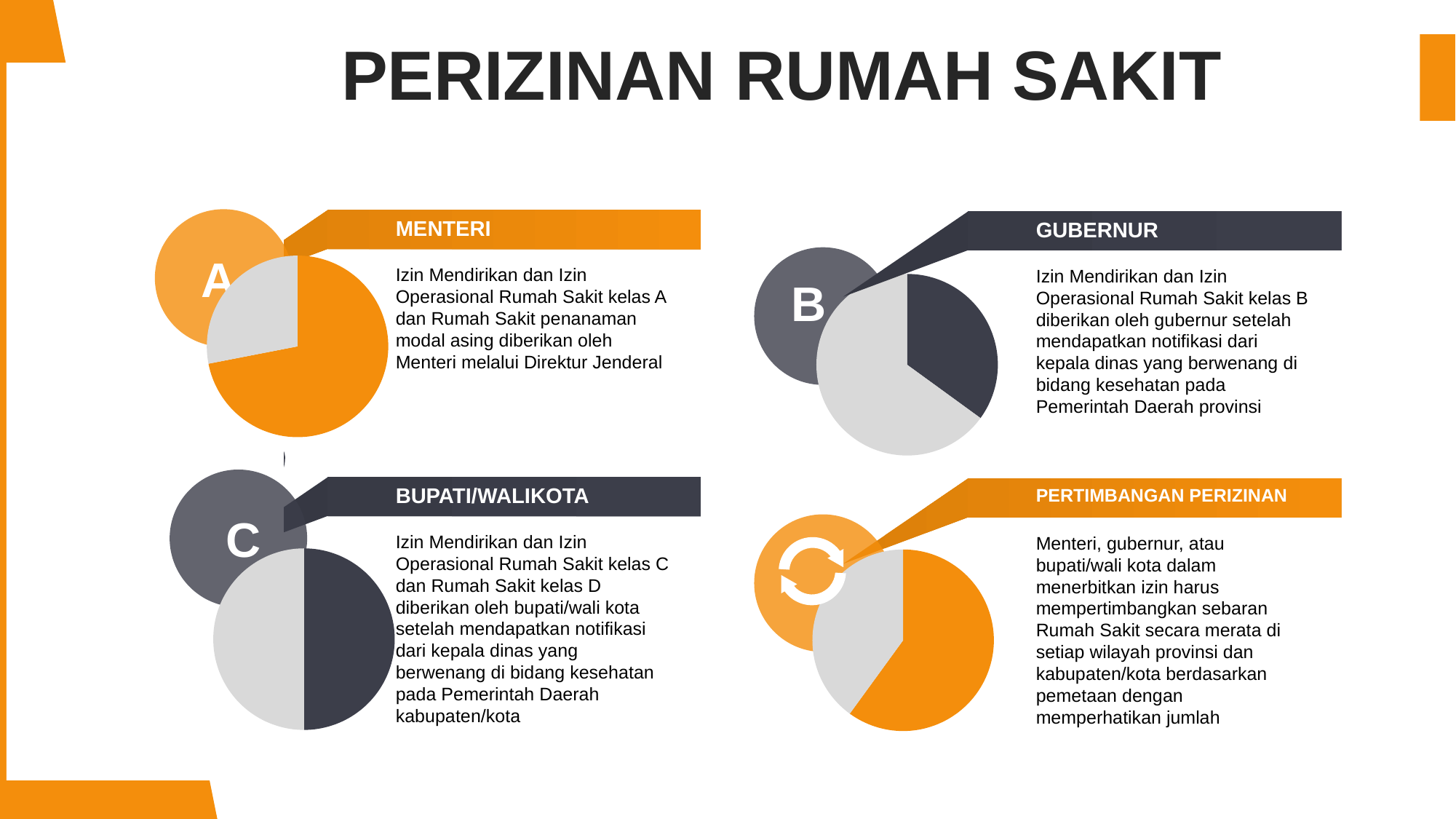
In the pie chart next to the MENTERI heading, which slice is larger, the orange one or the grey one? the orange one In the pie chart next to the PERTIMBANGAN PERIZINAN heading, which slice is larger, the orange one or the grey one? the orange one Which heading is placed next to the pie chart in the bottom-left of the slide? BUPATI/WALIKOTA What is the title of the slide containing the four pie charts? PERIZINAN RUMAH SAKIT What kind of chart is shown next to the MENTERI heading? pie chart What kind of chart is shown next to the GUBERNUR heading? pie chart How many pie charts are shown on the slide? 4 How many slices does the pie chart next to the PERTIMBANGAN PERIZINAN heading have? 2 In the pie chart next to the GUBERNUR heading, which slice is larger, the dark one or the light grey one? the light grey one How many slices does the pie chart next to the GUBERNUR heading have? 2